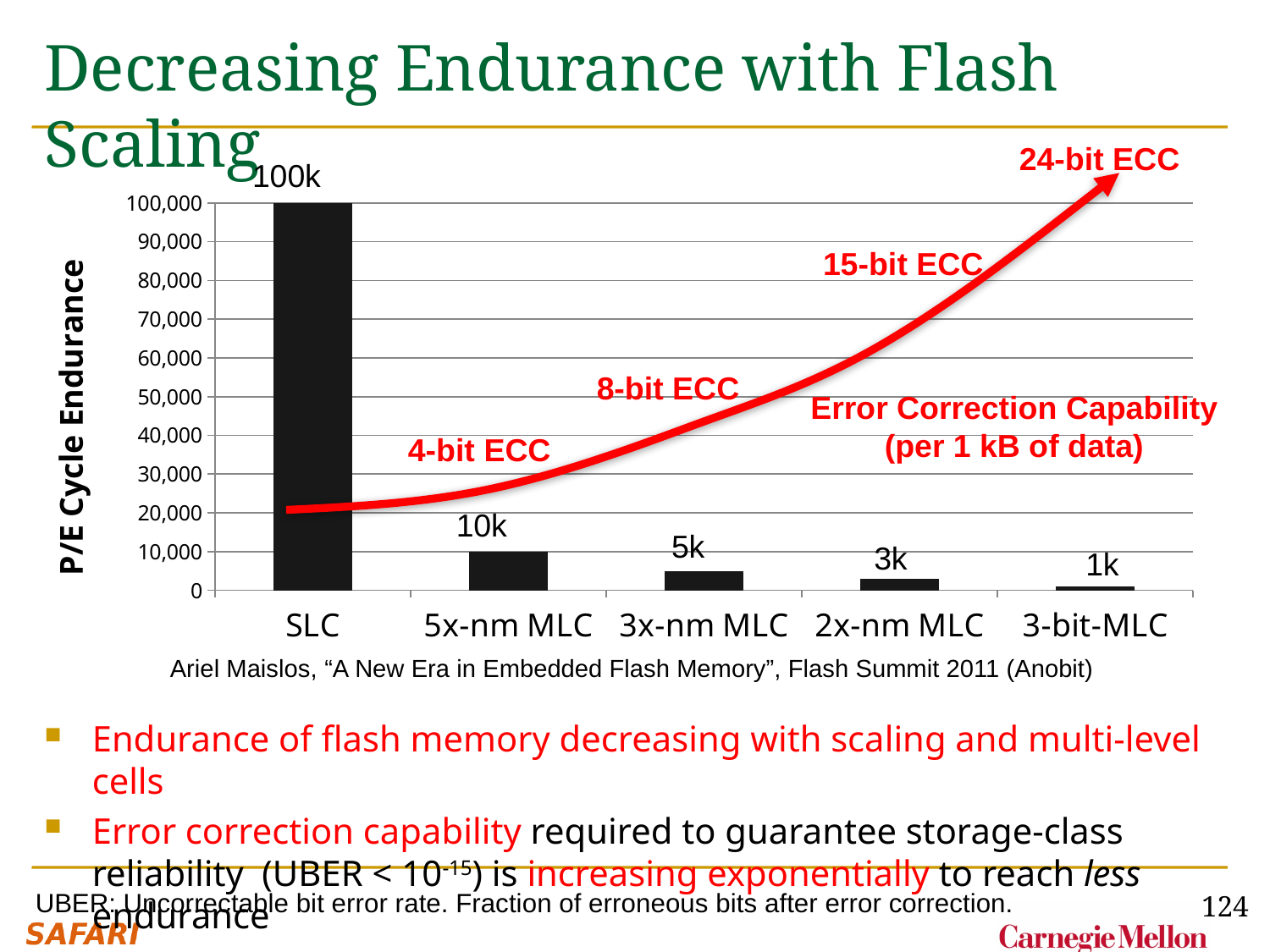
Which category has the lowest P/E cycle endurance? 3-bit-MLC How many categories are shown on the x axis of the chart? 5 What is the P/E cycle endurance for 5x-nm MLC? 10k What kind of chart is used to show P/E cycle endurance? bar chart What is the difference in P/E cycle endurance between 3x-nm MLC and 2x-nm MLC? 2k Which has a higher P/E cycle endurance, 5x-nm MLC or 2x-nm MLC? 5x-nm MLC Do the P/E cycle endurance values rise or fall from left to right along the x axis? fall Which category has the highest P/E cycle endurance? SLC What is the P/E cycle endurance for SLC? 100k What is the P/E cycle endurance for 3-bit-MLC? 1k Is the value for 3x-nm MLC greater or less than 10,000? less What is the label on the y axis of the chart? P/E Cycle Endurance